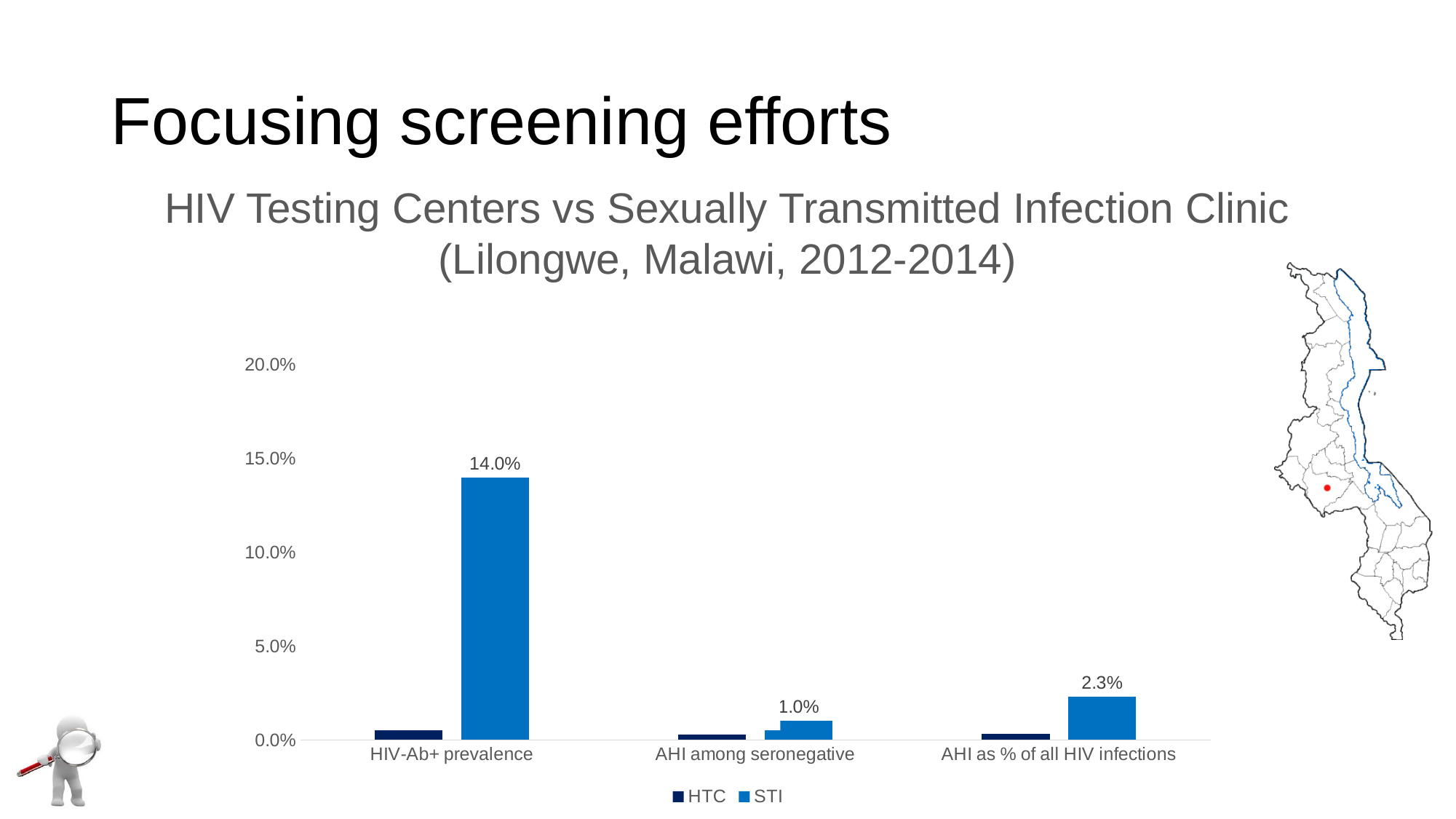
What is the STI value for AHI among seronegative? 1.0% What is the STI value for AHI as % of all HIV infections? 2.3% How many series does the legend list? 2 Is the STI value for HIV-Ab+ prevalence greater or less than 10.0%? greater What kind of chart is shown on the slide? Bar chart Which category has the highest STI value? HIV-Ab+ prevalence What is the STI value for HIV-Ab+ prevalence? 14.0% Which category has the lowest STI value? AHI among seronegative How many categories are shown on the x axis? 3 For HIV-Ab+ prevalence, which series has the larger value, HTC or STI? STI Is the HTC value for HIV-Ab+ prevalence greater or less than 5.0%? less What is the difference between the STI values for HIV-Ab+ prevalence and AHI as % of all HIV infections? 11.7%